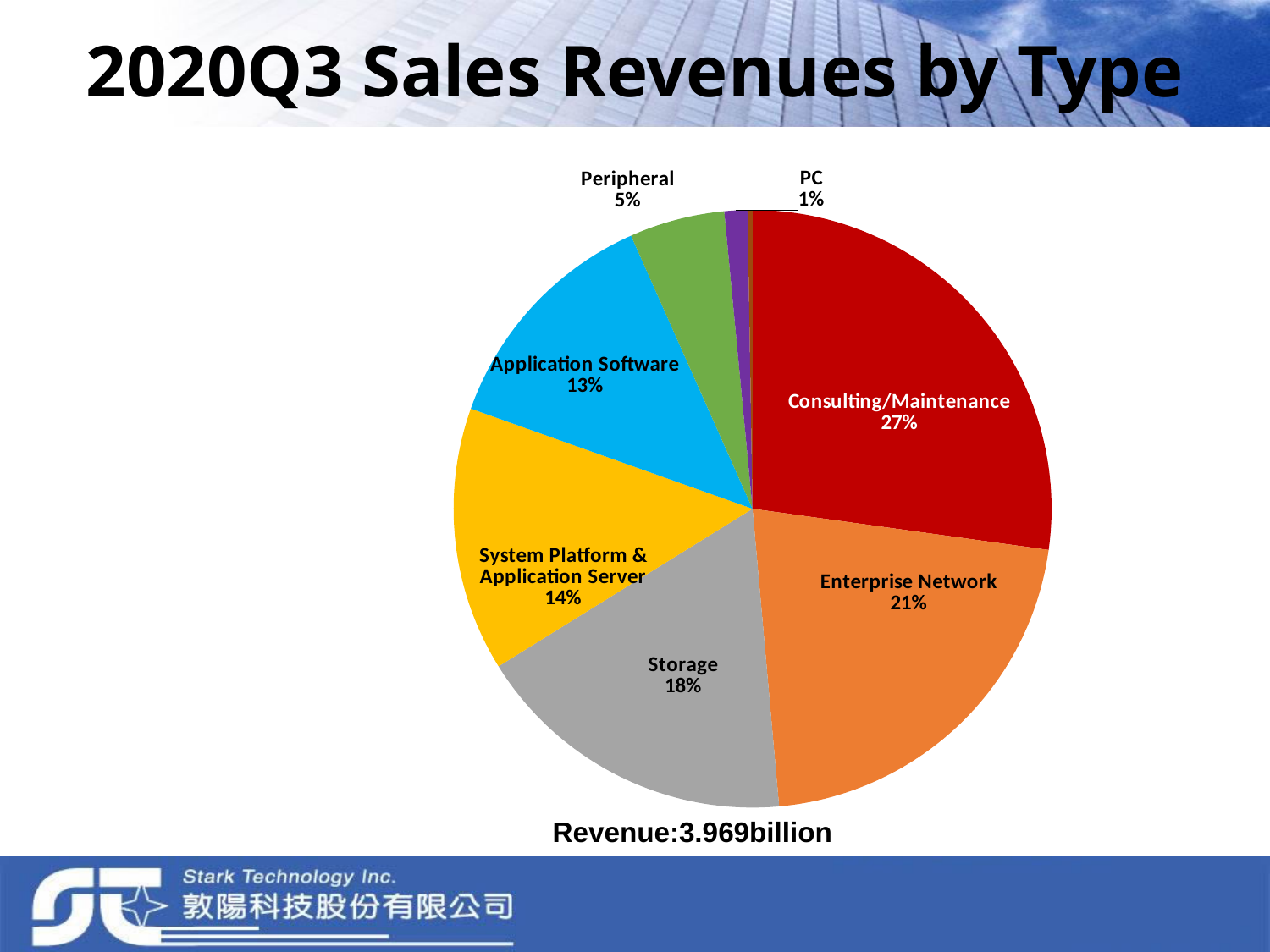
What share of 2020Q3 sales revenues comes from Consulting/Maintenance? 27% Which has a larger share, Storage or Application Software? Storage Which labelled type has the smallest share of the pie? PC What percentage is shown for System Platform & Application Server? 14% What percentage of the pie is Enterprise Network? 21% What percentage of the pie is Peripheral? 5% Which labelled type has the largest share of 2020Q3 sales revenues? Consulting/Maintenance How many percentage points larger is Consulting/Maintenance than Enterprise Network? 6 What kind of chart is shown on the slide? Pie chart What share of revenue is Application Software? 13% What total revenue figure is printed below the pie chart? Revenue:3.969billion What share does Storage hold in the pie chart? 18%